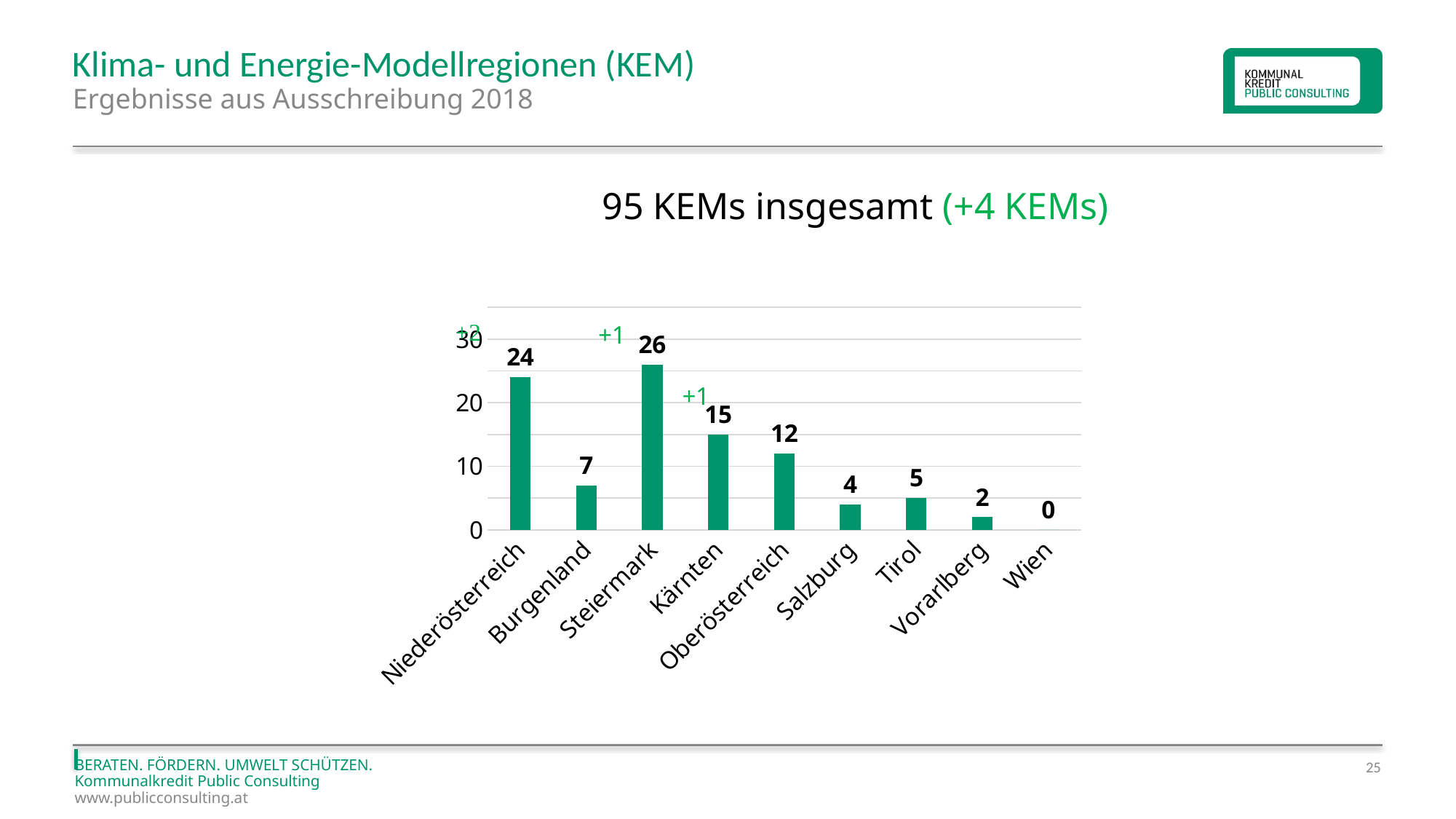
What kind of chart is shown on the slide? Bar chart What is the difference between the values for Steiermark and Niederösterreich? 2 Which is larger, the value for Tirol or the value for Salzburg? Tirol How many categories are shown on the x axis? 9 What is the value for Kärnten? 15 What is the value for Niederösterreich? 24 Which category has the lowest value? Wien Which category has the highest value? Steiermark What is the value for Steiermark? 26 What is the heading above the chart? 95 KEMs insgesamt (+4 KEMs) What is the value for Wien? 0 What is the difference between the values for Oberösterreich and Burgenland? 5